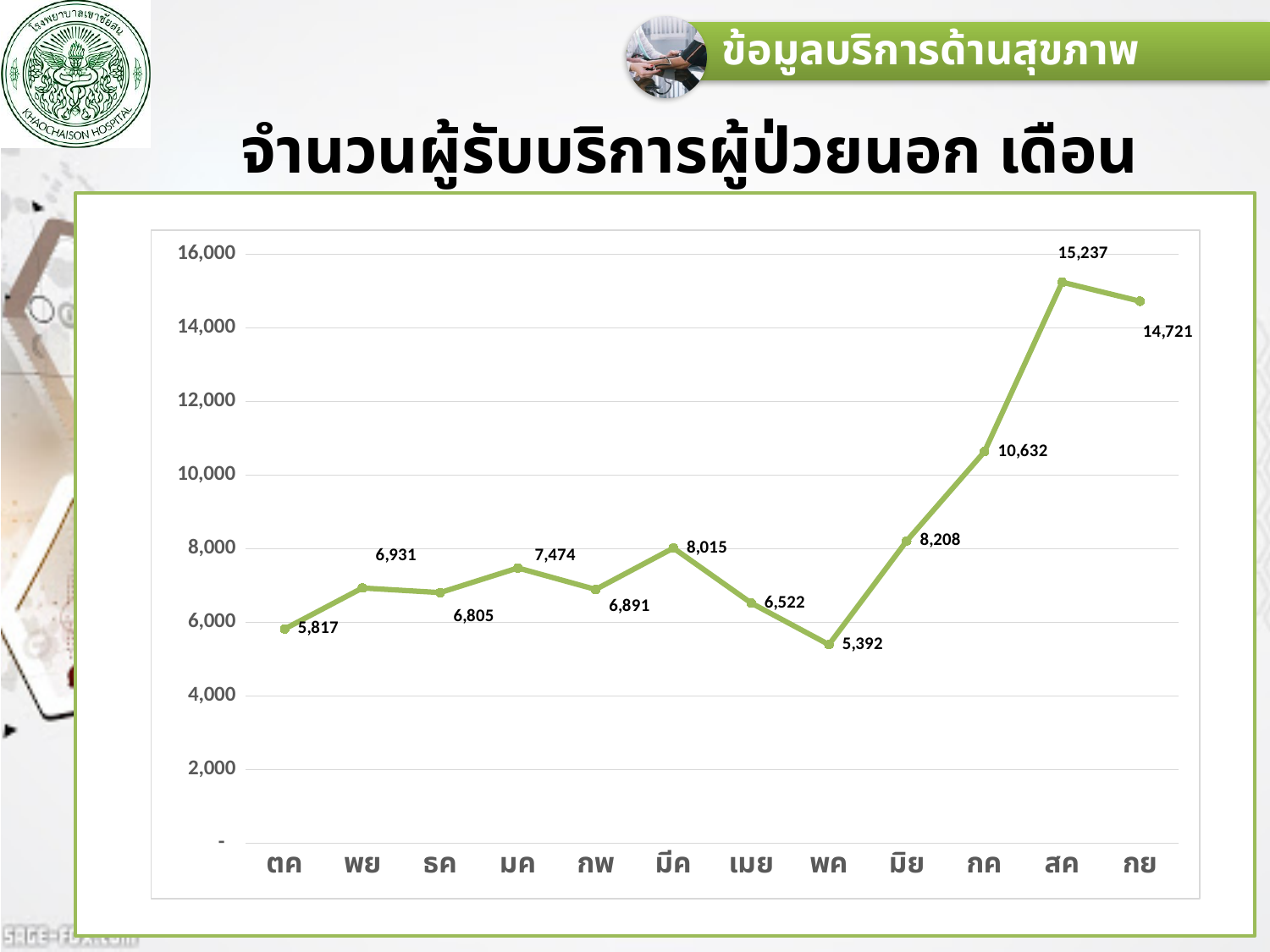
What is the value for กค? 10,632 Is the value for กค greater or less than 10,000? greater What is the difference between the values for สค and กย? 516 What is the value for สค? 15,237 Which month has the highest value? สค What is the value for ตค? 5,817 What kind of chart is shown on the slide? line chart Which month has the lowest value? พค How many months are plotted on the x axis? 12 Which is larger, the value for มีค or the value for มิย? มิย What is the value for พค? 5,392 What is the difference between the values for มิย and พค? 2,816